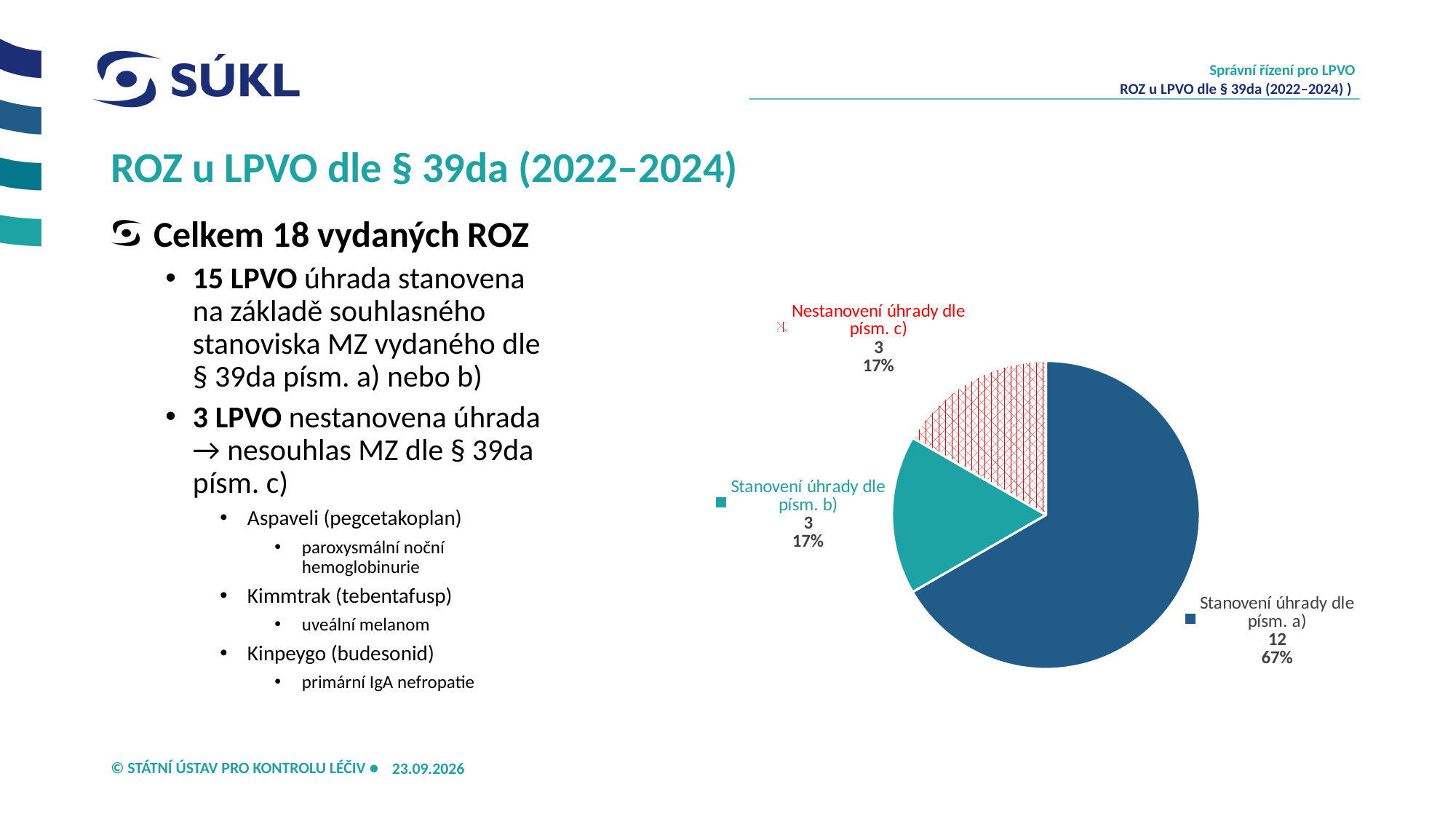
What is the value for "Stanovení úhrady dle písm. a)" in the pie chart? 12 Which is larger: the value for "Stanovení úhrady dle písm. a)" or "Nestanovení úhrady dle písm. c)"? Stanovení úhrady dle písm. a) Which category has the largest slice in the pie chart? Stanovení úhrady dle písm. a) What share of the pie does "Nestanovení úhrady dle písm. c)" represent? 17% What share of the pie does "Stanovení úhrady dle písm. a)" represent? 67% How many slices does the pie chart have? 3 What is the value for "Stanovení úhrady dle písm. b)" in the pie chart? 3 What is the value for "Nestanovení úhrady dle písm. c)" in the pie chart? 3 What kind of chart is shown on the slide? pie chart What is the difference between the values for "Stanovení úhrady dle písm. a)" and "Stanovení úhrady dle písm. b)"? 9 What is the total of all slices in the pie chart? 18 Which slice of the pie chart is drawn with a red hatched pattern? Nestanovení úhrady dle písm. c)